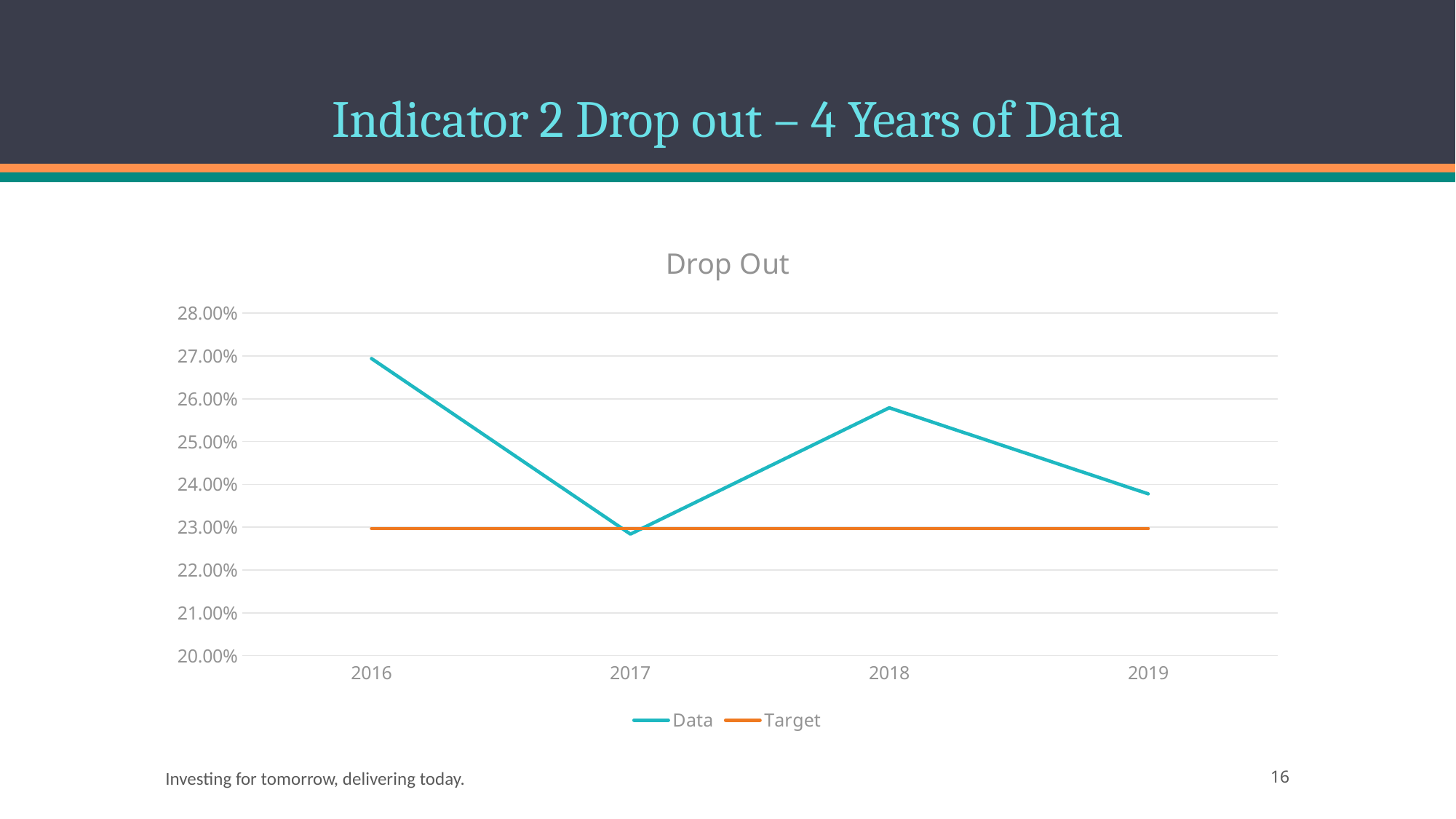
How many years are plotted on the x axis? 4 What is the title of the chart? Drop Out What kind of chart is shown on the slide? line chart In which year is the Data series lowest? 2017 Is the Data value for 2018 greater or less than 25.00%? greater Is the Target value greater or less than 24.00%? less How many series does the legend list? 2 Is the Data value for 2017 greater or less than 24.00%? less In which year is the Data series highest? 2016 Does the Data series rise or fall from 2016 to 2017? fall Which year has the larger Data value, 2016 or 2018? 2016